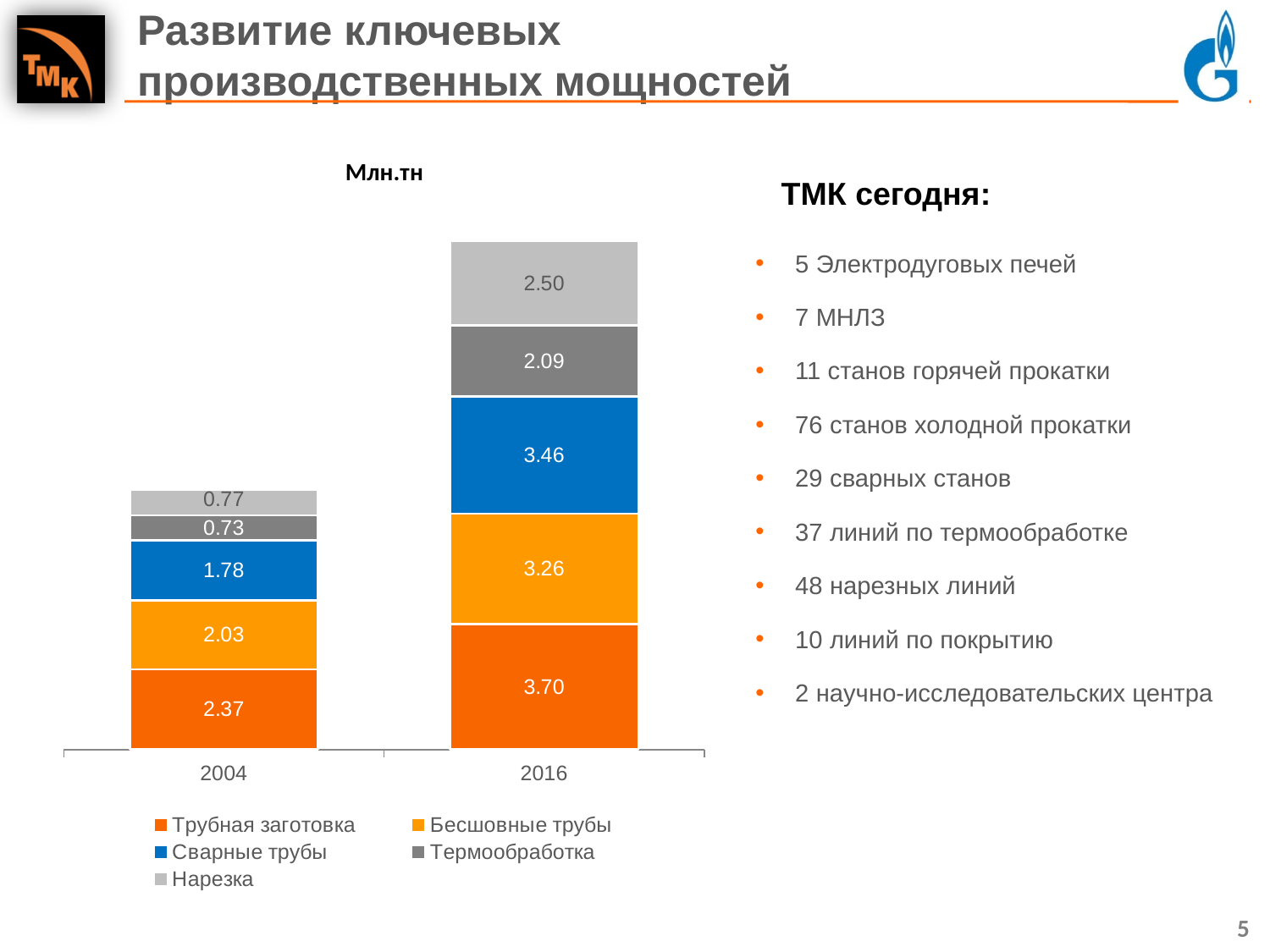
What is the value for Трубная заготовка in 2004? 2.37 Which is larger in 2016: Трубная заготовка or Термообработка? Трубная заготовка How many categories are shown on the x axis? 2 What unit is given in the chart title? Млн.тн How many series does the legend list? 5 What is the total of the stacked bar for 2016? 15.01 What is the total of the stacked bar for 2004? 7.68 What type of chart is shown on the slide? Stacked bar chart What is the value for Нарезка in 2016? 2.50 What is the difference between the Бесшовные трубы values for 2016 and 2004? 1.23 What is the value for Термообработка in 2004? 0.73 What is the value for Сварные трубы in 2016? 3.46